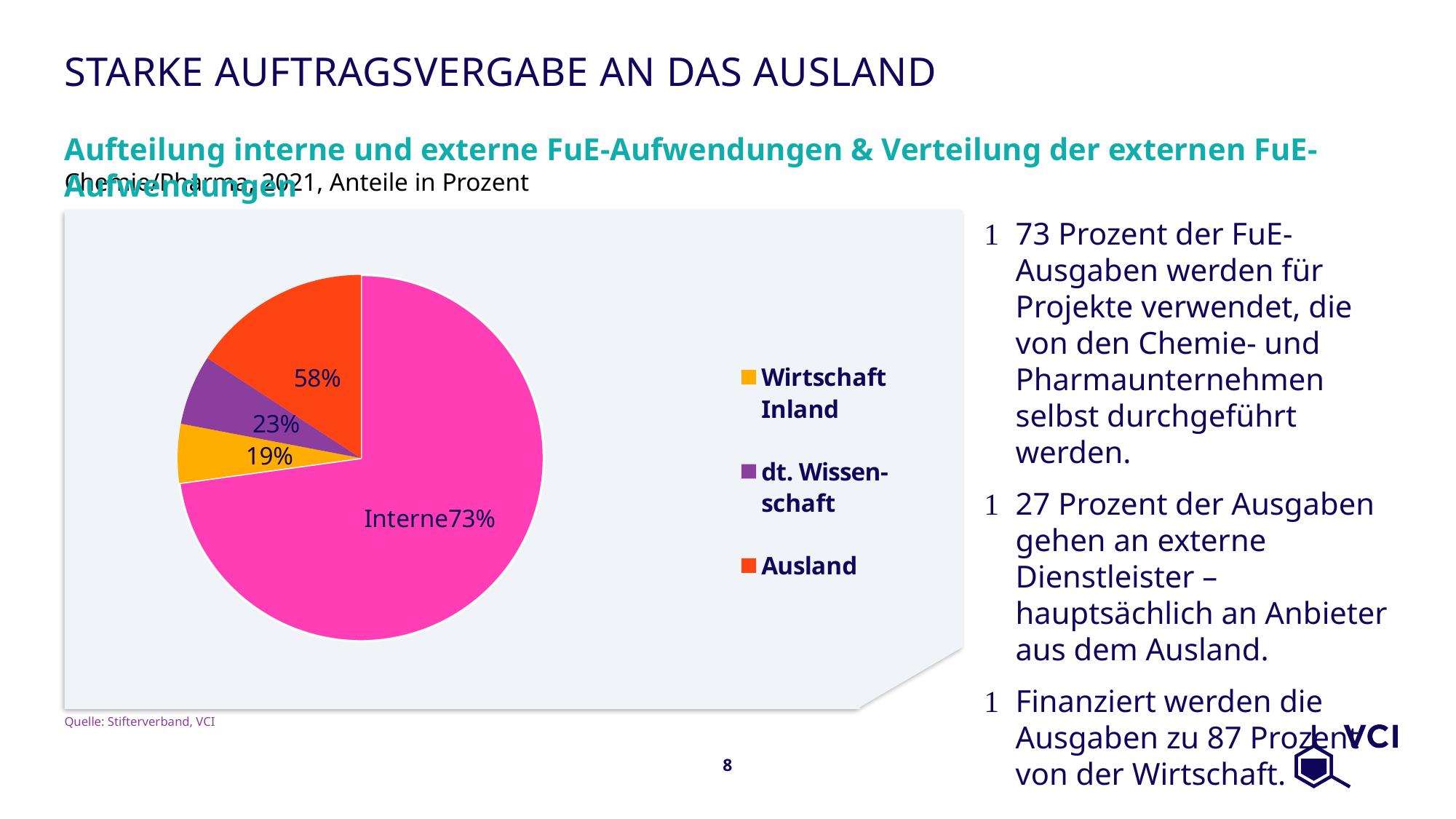
How many entries does the legend of the pie chart list? 3 Which slice of the pie chart is the largest? Interne What percentage label is shown on the Wirtschaft Inland slice? 19% What percentage is shown for the Interne slice of the pie chart? 73% What percentage label is shown on the dt. Wissenschaft slice? 23% What percentage label is shown on the Ausland slice? 58% Which has the larger labelled percentage, Ausland or dt. Wissenschaft? Ausland Which of the three external slices has the largest labelled percentage? Ausland What is the difference in percentage points between the Ausland label (58%) and the dt. Wissenschaft label (23%)? 35 percentage points What kind of chart is shown on the slide? pie chart Which of the three external slices (Wirtschaft Inland, dt. Wissenschaft, Ausland) has the smallest labelled percentage? Wirtschaft Inland How many slices does the pie chart have? 4